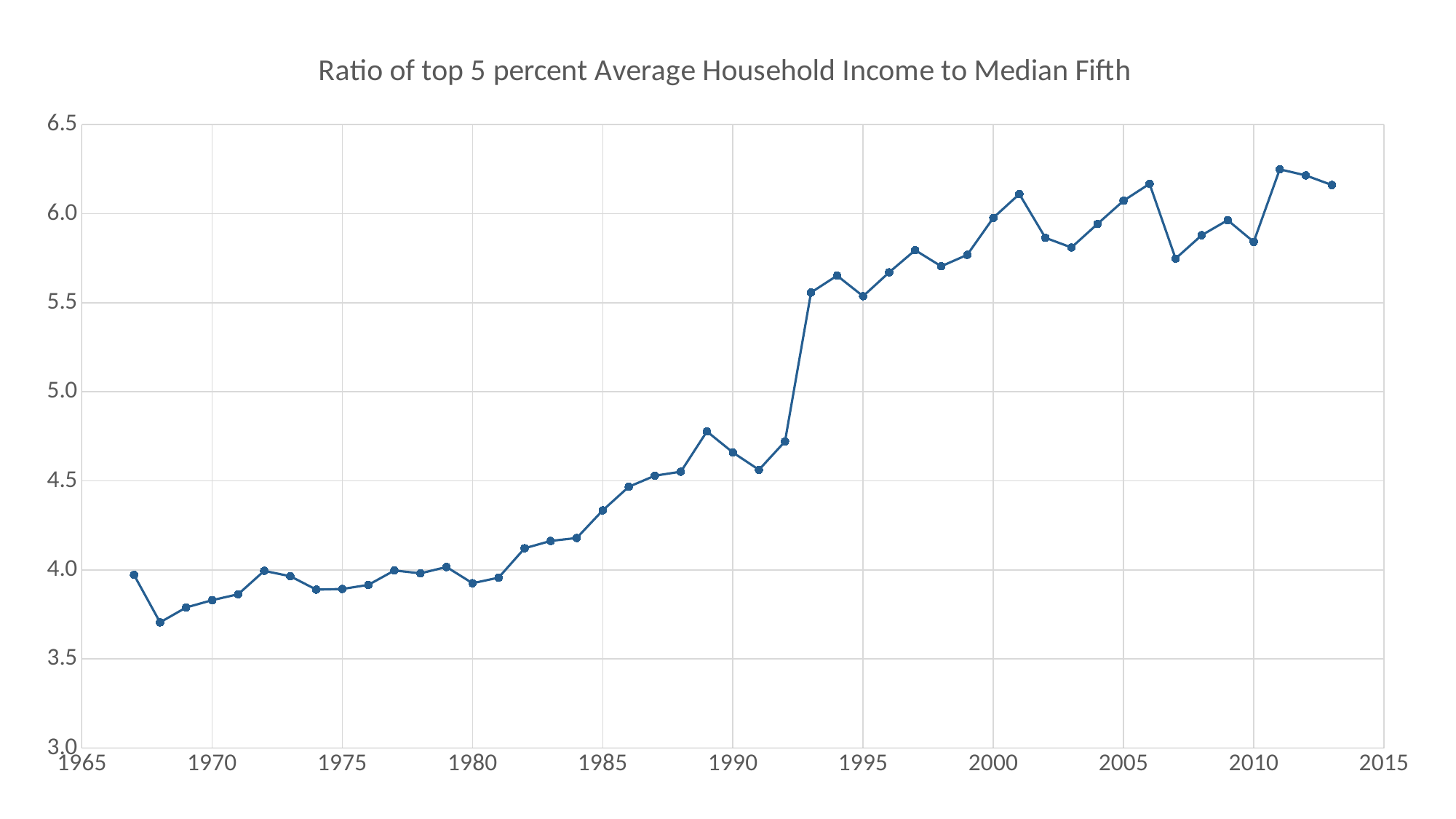
What kind of chart is shown on the slide? line chart Overall, do the values rise or fall from 1967 to 2013? rise What is the highest value shown on the vertical axis? 6.5 Is the value for 1968 greater or less than 4.0? less Is the value for 2007 greater or less than 6.0? less Which year has the lowest ratio on the chart? 1968 Is the value for 1985 greater or less than 4.5? less Which year has the larger ratio, 1992 or 1993? 1993 What is the title of the chart? Ratio of top 5 percent Average Household Income to Median Fifth Which year has the larger ratio, 2006 or 2007? 2006